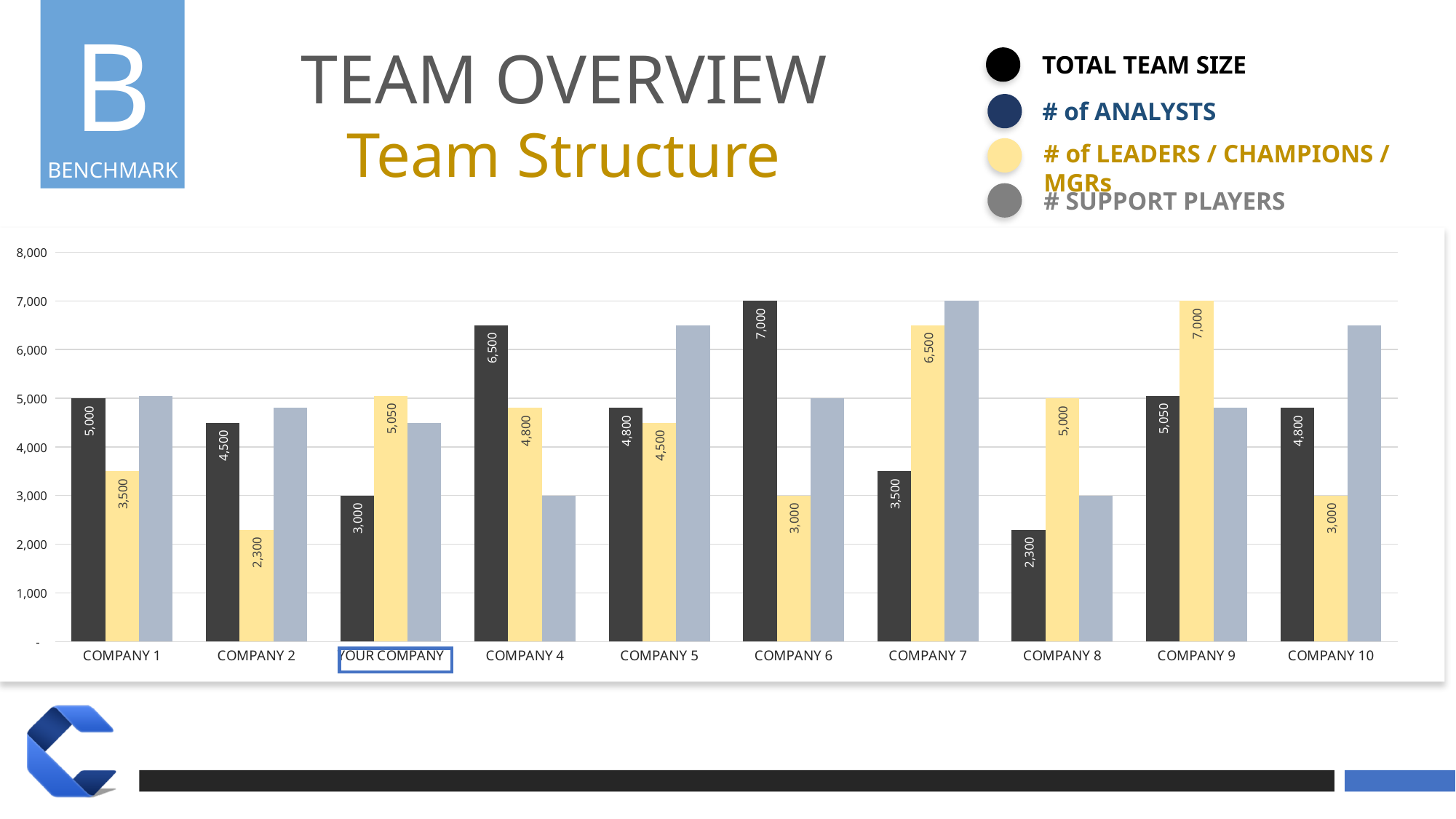
Which company has the lowest Total Team Size? Company 8 How many companies are shown on the x axis of the chart? 10 How many series does the legend list? 4 Is the # Support Players value for Company 5 greater or less than 6,000? greater Which company has the highest Total Team Size? Company 6 Which is larger: the Total Team Size of Company 2 or the Total Team Size of Company 7? Company 2 What is the # of Leaders / Champions / MGRs value for Your Company? 5,050 Which company has the highest # of Leaders / Champions / MGRs? Company 9 What is the Total Team Size value for Company 4? 6,500 What is the Total Team Size value for Company 9? 5,050 What is the difference between the Total Team Size of Company 6 and Your Company? 4,000 What kind of chart is shown on the slide? Bar chart